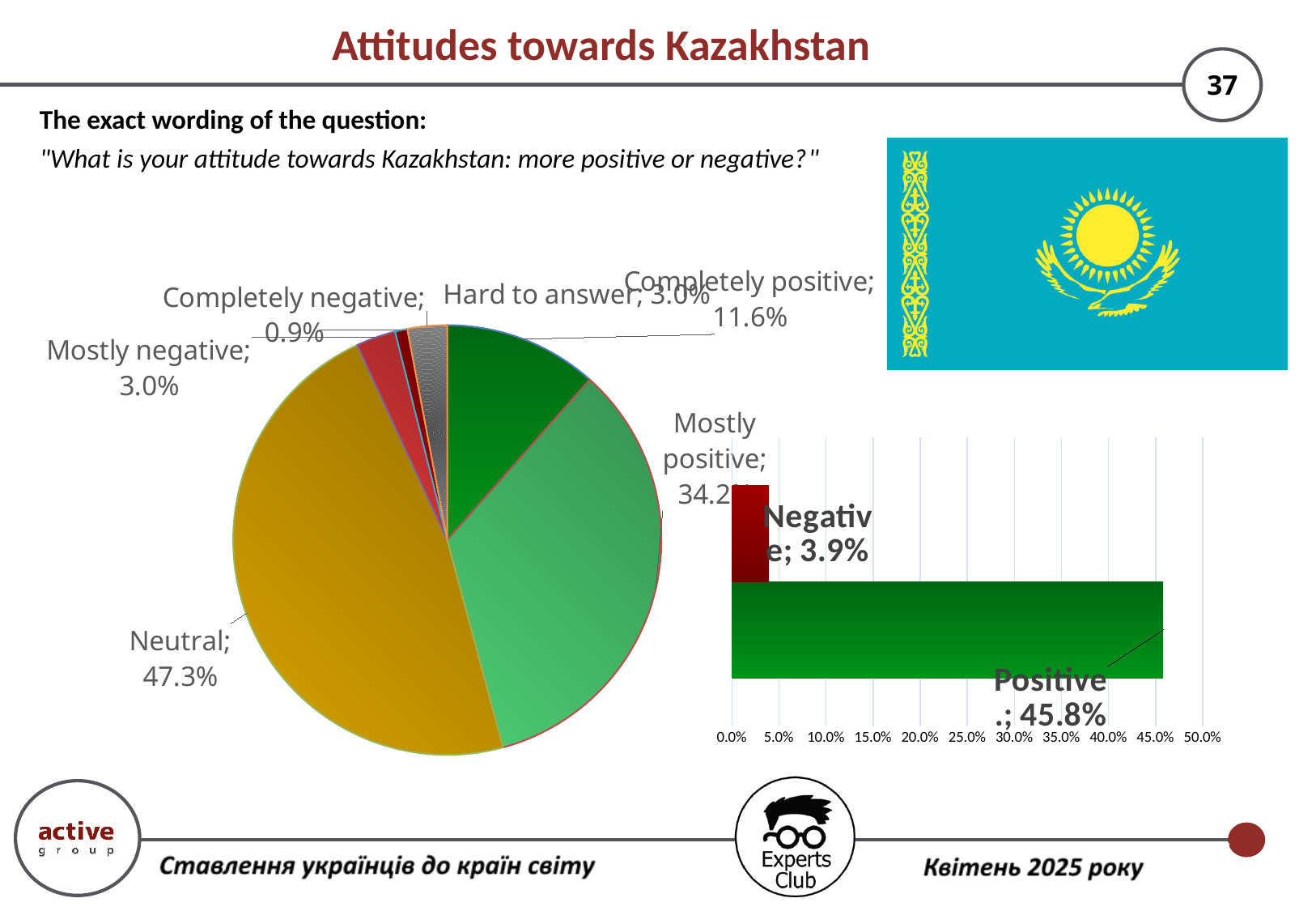
In the pie chart, which category has the smallest slice? Completely negative In the pie chart, which category has the largest slice? Neutral In the bar chart on the right, what is the value for Positive? 45.8% In the pie chart, what is the value for Mostly negative? 3.0% How many slices does the pie chart have? 6 What kind of chart is the one on the right showing Negative and Positive? Bar chart In the bar chart on the right, what is the difference between the Positive and Negative values? 41.9 percentage points In the pie chart, what is the difference between the Neutral share and the Completely positive share? 35.7 percentage points In the pie chart, what is the value for Completely negative? 0.9% In the bar chart on the right, what is the value for Negative? 3.9% In the pie chart, what is the value for Completely positive? 11.6% In the pie chart, what share of respondents answered Neutral? 47.3%